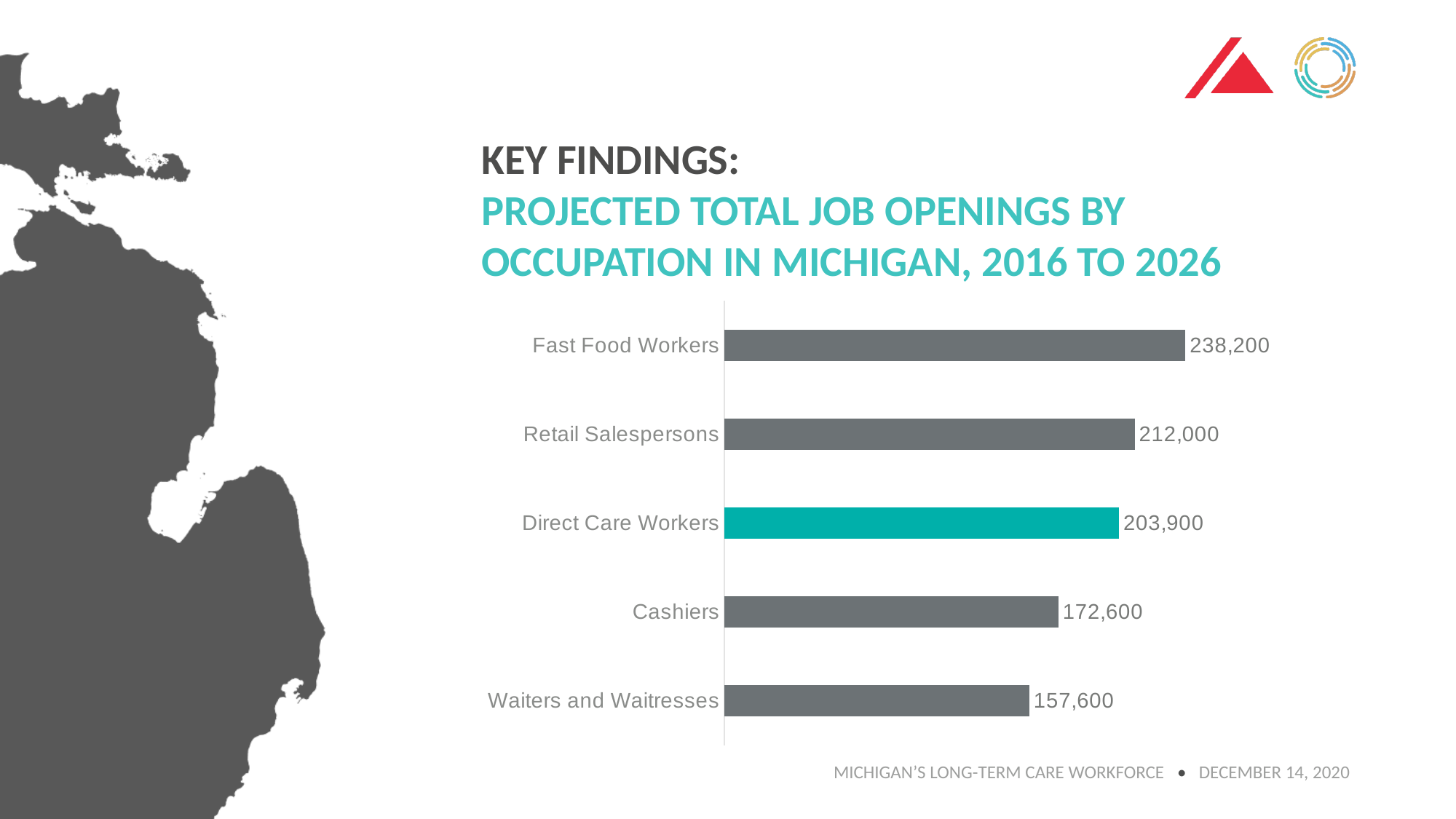
How many occupations are shown in the chart? 5 What is the projected total job openings value for Waiters and Waitresses? 157,600 What is the difference in projected job openings between Fast Food Workers and Retail Salespersons? 26,200 What is the difference in projected job openings between Direct Care Workers and Cashiers? 31,300 What is the projected total job openings value for Direct Care Workers? 203,900 What kind of chart is shown on the slide? Bar chart Which occupation has the highest projected total job openings? Fast Food Workers What is the projected total job openings value for Cashiers? 172,600 Which occupation's bar is highlighted in teal rather than grey? Direct Care Workers Which has more projected job openings, Retail Salespersons or Direct Care Workers? Retail Salespersons What is the projected total job openings value for Fast Food Workers? 238,200 Which occupation has the lowest projected total job openings? Waiters and Waitresses